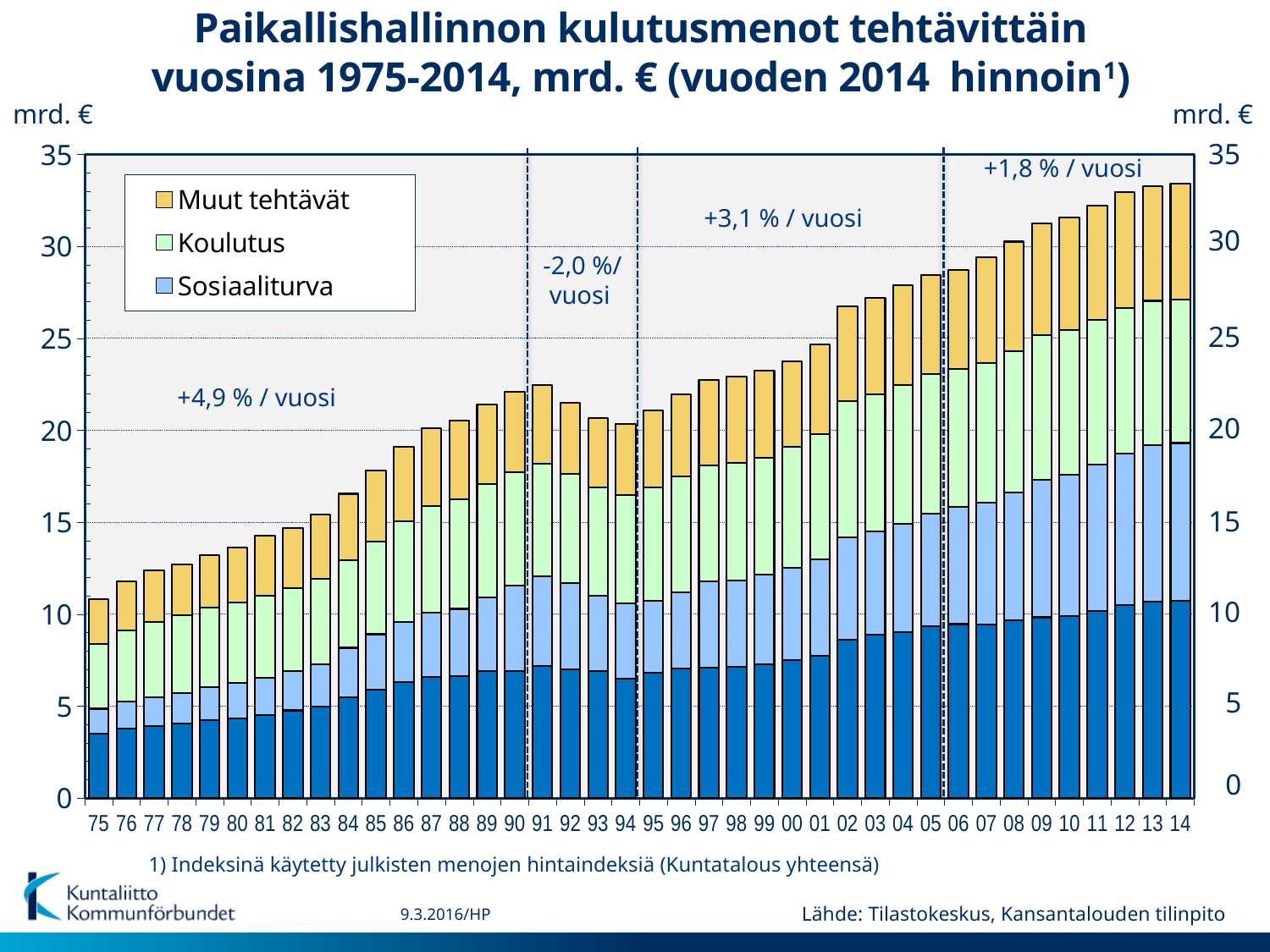
Do the total values generally rise or fall from 75 to 14? rise Which year has the larger total bar, 90 or 94? 90 How many series does the legend list? 3 How many years (bars) are plotted on the x axis? 40 What kind of chart is shown on the slide? stacked bar chart Which year has the lowest total bar? 75 What annual growth rate is annotated for the period between the first two dashed lines (91-94)? -2,0 %/ vuosi Which year has the highest total bar? 14 Is the total value for 14 greater or less than 30? greater Is the total value for 75 greater or less than 15? less Is the Sosiaaliturva value for 14 greater or less than 10? less